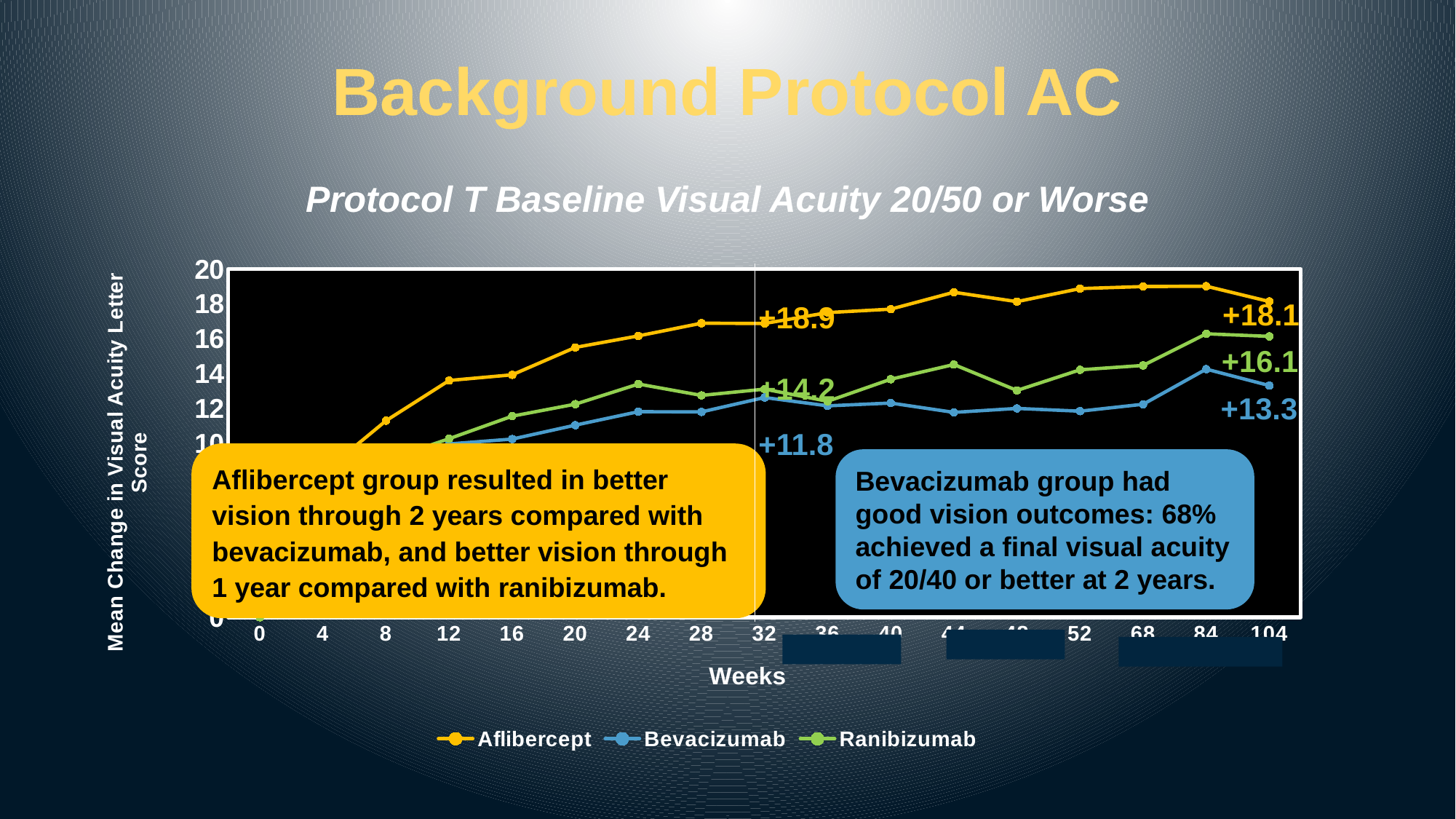
What is the first data label shown on the Bevacizumab line? +11.8 Is the value for Aflibercept at week 44 greater or less than 18? greater What is the label on the x axis of the chart? Weeks Does the Aflibercept line rise or fall between week 0 and week 52? Rise What is the data label for Aflibercept at week 104? +18.1 What kind of chart is shown on the slide? Line chart What is the difference between the Aflibercept and Bevacizumab values at week 104? 4.8 What is the data label for Ranibizumab at week 104? +16.1 What is the data label for Bevacizumab at week 104? +13.3 Which series has the highest value at week 104? Aflibercept How many series does the legend list? 3 Which series has the lowest value at week 104? Bevacizumab